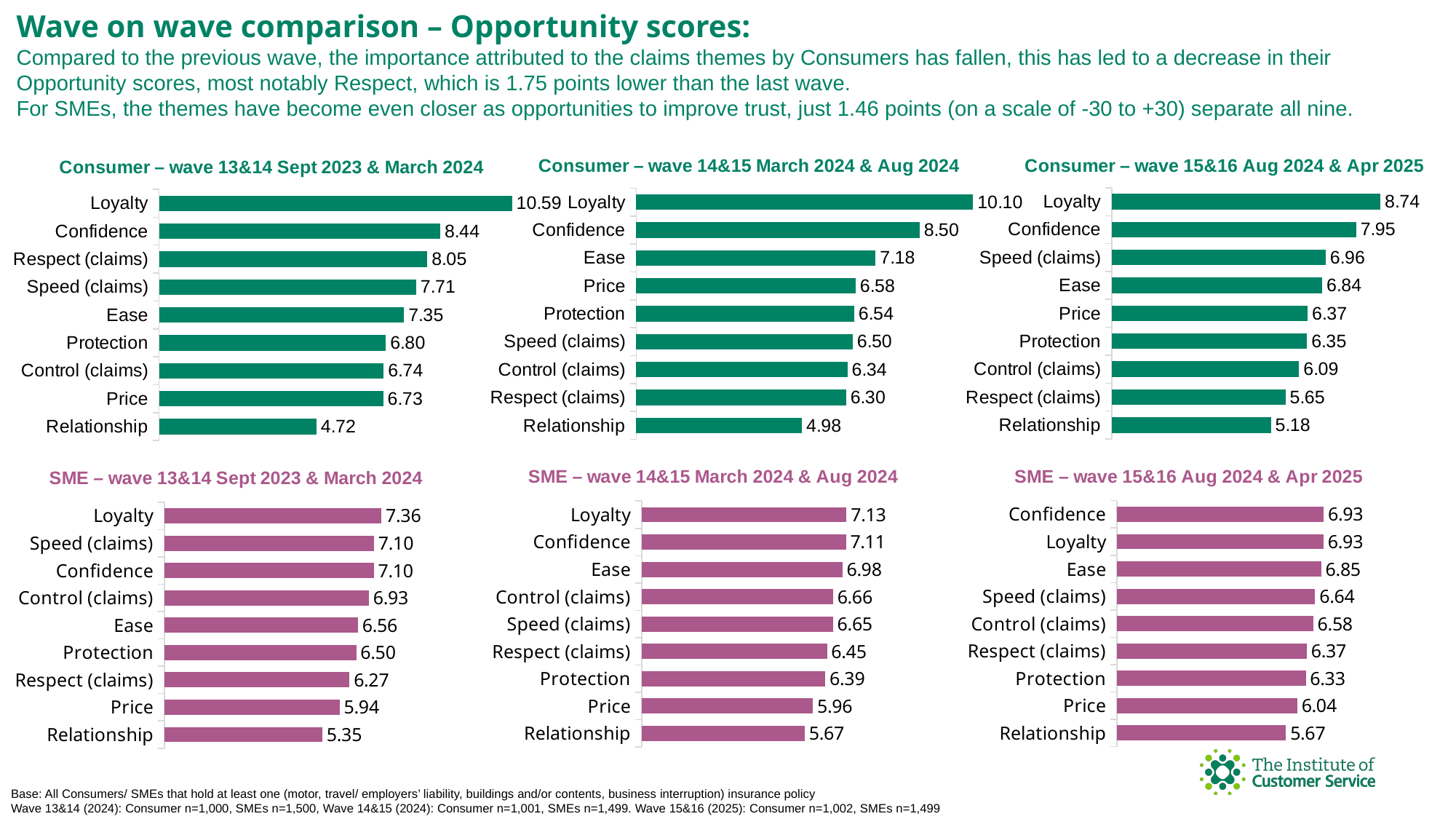
In the 'SME – wave 13&14 Sept 2023 & March 2024' chart, what is the difference between Loyalty and Price? 1.42 In the 'Consumer – wave 15&16 Aug 2024 & Apr 2025' chart, what is the value for Respect (claims)? 5.65 What colour are the bars in the SME charts? Purple/magenta In the 'Consumer – wave 14&15 March 2024 & Aug 2024' chart, which category has the highest value? Loyalty In the 'Consumer – wave 14&15 March 2024 & Aug 2024' chart, which is larger, Ease or Price? Ease How many charts are shown on the slide? 6 In the 'SME – wave 14&15 March 2024 & Aug 2024' chart, what is the value for Price? 5.96 How many categories are shown in the 'SME – wave 14&15 March 2024 & Aug 2024' chart? 9 What type of chart is the 'Consumer – wave 13&14 Sept 2023 & March 2024' chart? Bar chart In the 'SME – wave 15&16 Aug 2024 & Apr 2025' chart, which category has the lowest value? Relationship In the 'Consumer – wave 15&16 Aug 2024 & Apr 2025' chart, what is the difference between Loyalty and Relationship? 3.56 In the 'Consumer – wave 13&14 Sept 2023 & March 2024' chart, what is the value for Loyalty? 10.59